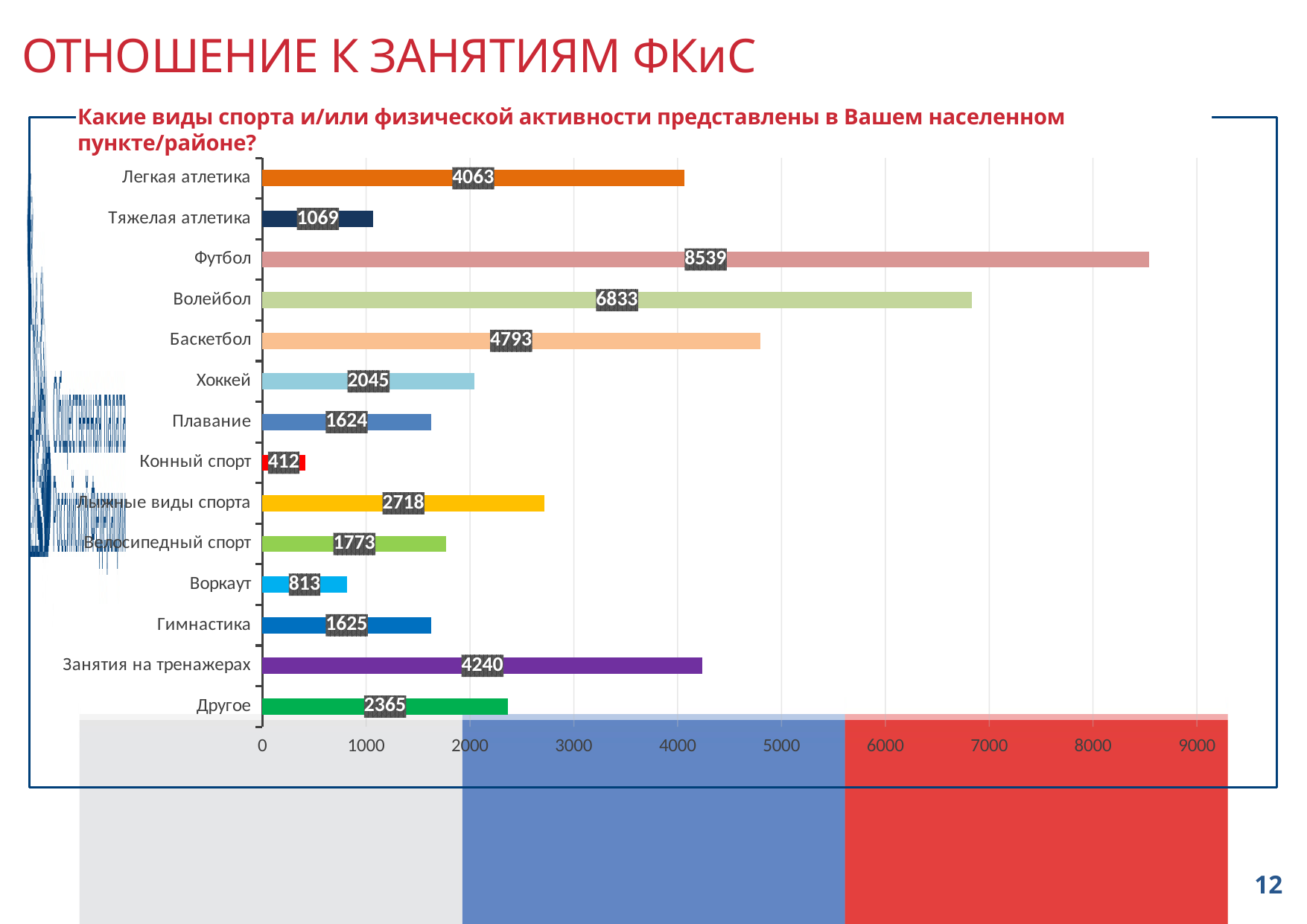
Which category has the highest value? Футбол What is the difference between the values for Футбол and Волейбол? 1706 Which is larger, the value for Баскетбол or the value for Легкая атлетика? Баскетбол How many categories are shown in the chart? 14 Which category has the lowest value? Конный спорт What is the difference between the values for Хоккей and Воркаут? 1232 What is the value for Занятия на тренажерах? 4240 Is the value for Лыжные виды спорта greater or less than 3000? less What is the value for Волейбол? 6833 What is the value for Футбол? 8539 What is the value for Конный спорт? 412 What kind of chart is shown on the slide? bar chart